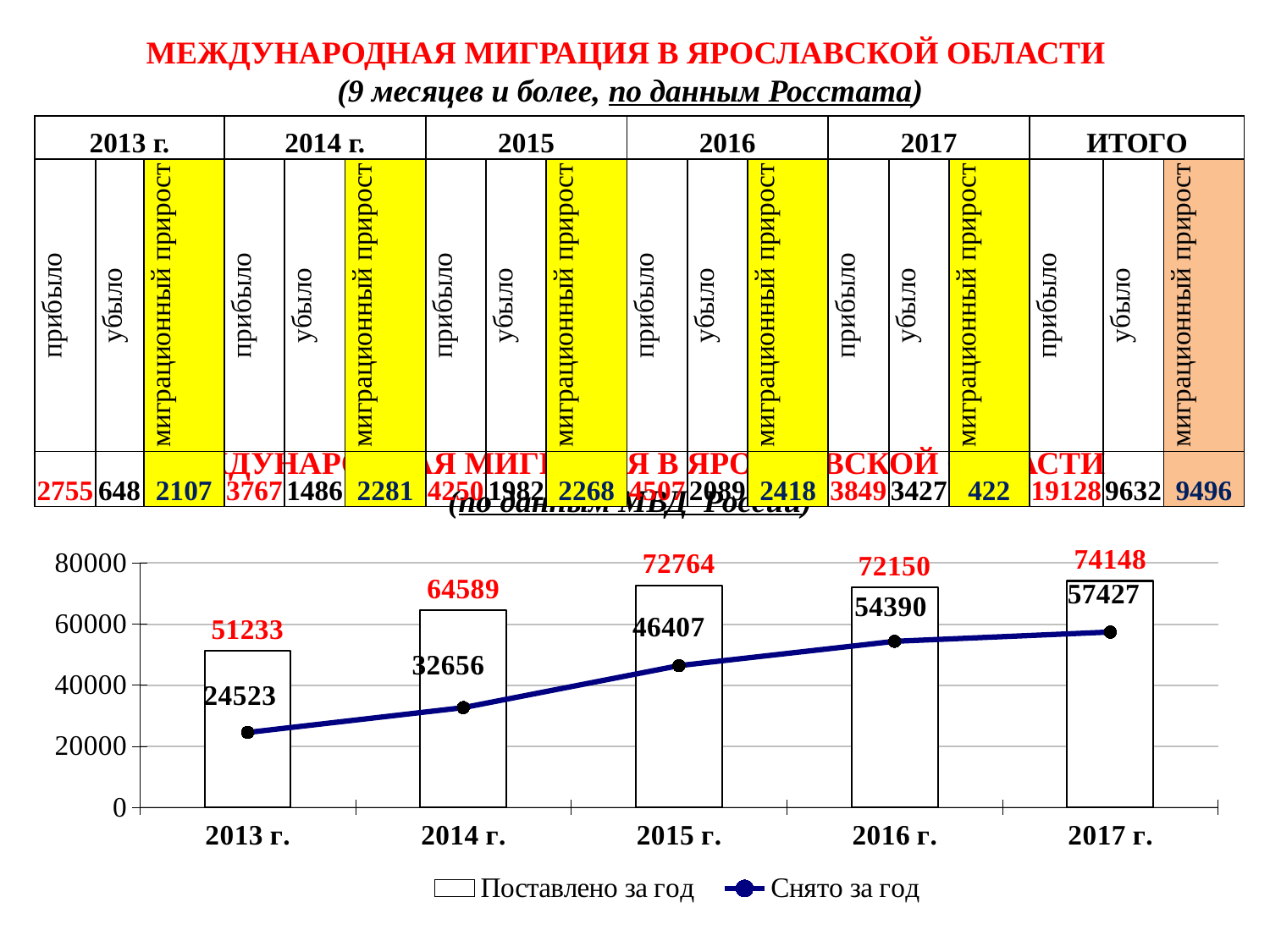
What is the value of "Поставлено за год" for 2015 г.? 72764 Which is larger: "Поставлено за год" in 2015 г. or in 2016 г.? 2015 г. Is the value of "Снято за год" for 2016 г. greater or less than 40000? greater What is the difference between "Поставлено за год" and "Снято за год" in 2014 г.? 31933 What is the value of "Снято за год" for 2017 г.? 57427 How many series does the chart legend list? 2 What is the value of "Снято за год" for 2013 г.? 24523 How many years are shown on the x axis of the chart? 5 What kind of chart is used for the "Снято за год" series? line chart Does the "Снято за год" series rise or fall from 2013 г. to 2017 г.? rise In which year is "Поставлено за год" the highest? 2017 г. In which year is "Снято за год" the lowest? 2013 г.